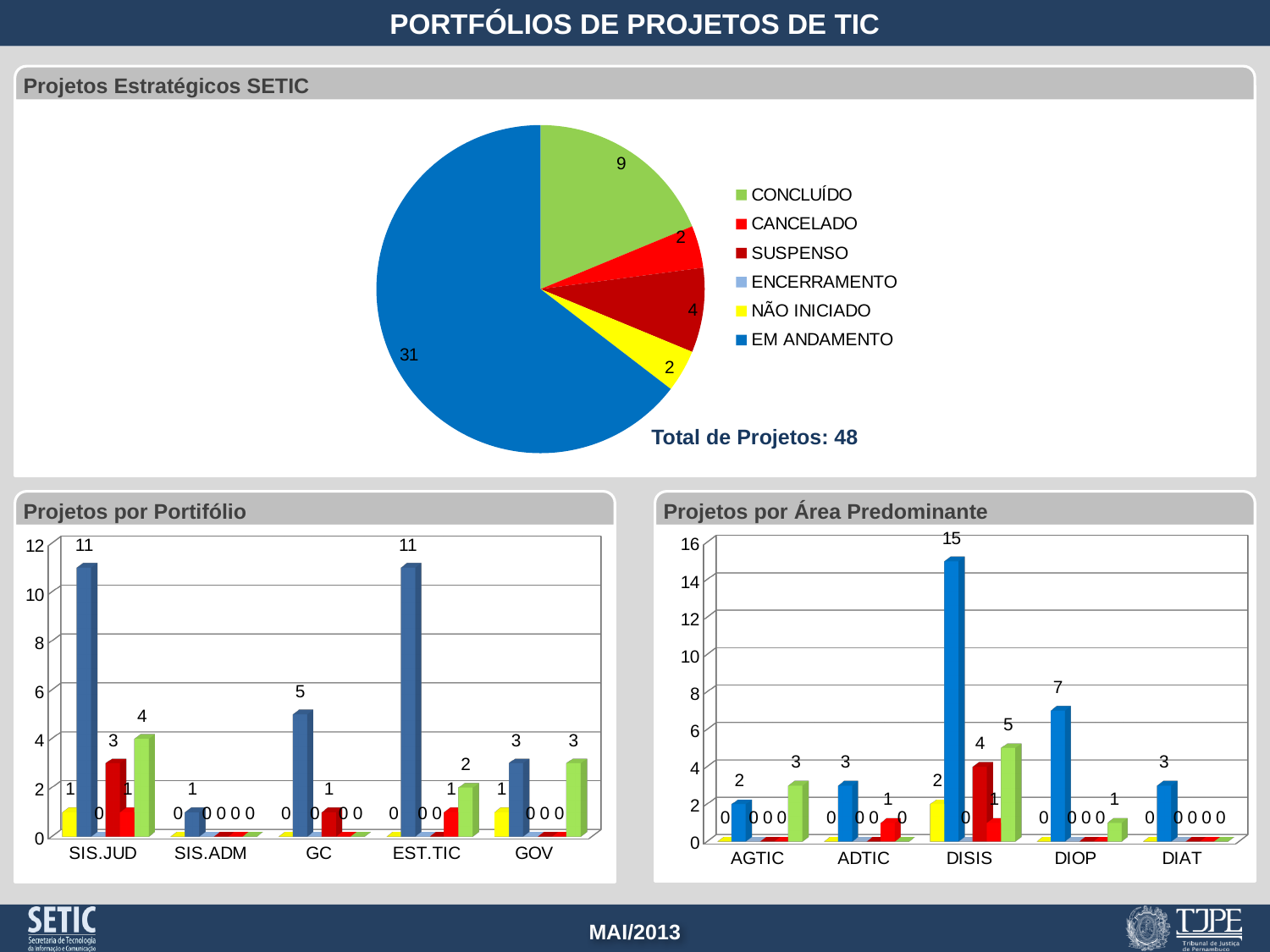
In the pie chart 'Projetos Estratégicos SETIC', what is the value for CONCLUÍDO? 9 In the pie chart 'Projetos Estratégicos SETIC', what is the difference between CONCLUÍDO and SUSPENSO? 5 In the chart 'Projetos por Área Predominante', how many categories are shown on the x axis? 5 How many entries does the legend of the pie chart 'Projetos Estratégicos SETIC' list? 6 What kind of chart is 'Projetos Estratégicos SETIC'? pie chart In the chart 'Projetos por Área Predominante', what is the highest value labeled, and for which category? 15, DISIS In the pie chart 'Projetos Estratégicos SETIC', which category has the largest slice? EM ANDAMENTO What total number of projects is stated next to the pie chart 'Projetos Estratégicos SETIC'? 48 In the pie chart 'Projetos Estratégicos SETIC', what is the value for EM ANDAMENTO? 31 What kind of chart is 'Projetos por Portifólio'? bar chart In the chart 'Projetos por Portifólio', how many categories are shown on the x axis? 5 In the chart 'Projetos por Área Predominante', what is the value of the tallest bar for DIOP? 7